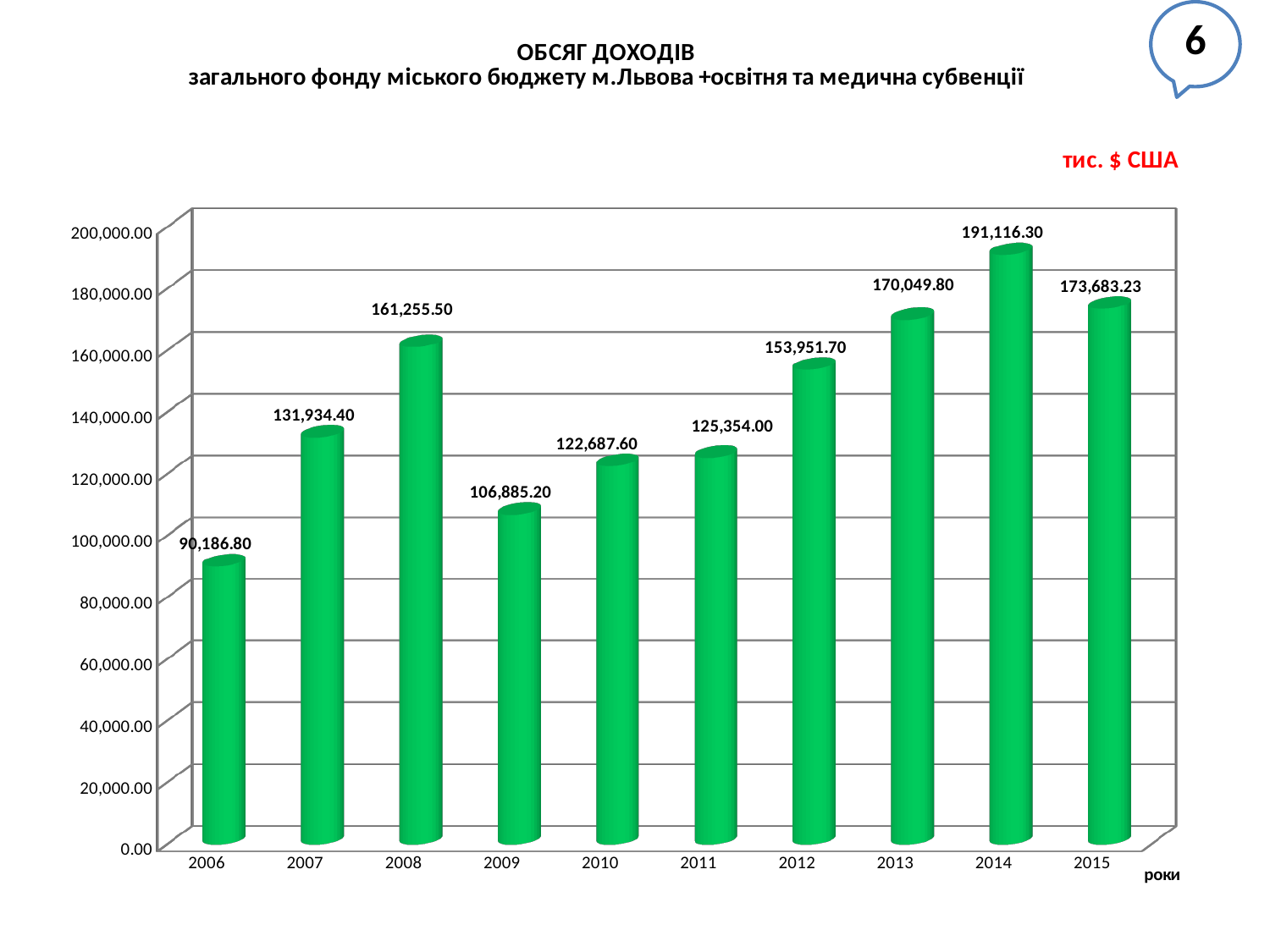
What is the value for 2015? 173,683.23 What is the difference between the values for 2014 and 2006? 100,929.50 Which year has the lowest value? 2006 Which year has the highest value? 2014 What kind of chart is shown on the slide? bar chart What is the value for 2011? 125,354.00 Which is larger, the value for 2012 or the value for 2011? 2012 What is the value for 2008? 161,255.50 What is the difference between the values for 2008 and 2009? 54,370.30 How many years are shown on the x axis? 10 Do the values rise or fall from 2009 to 2014? rise Is the value for 2013 greater or less than 160,000.00? greater